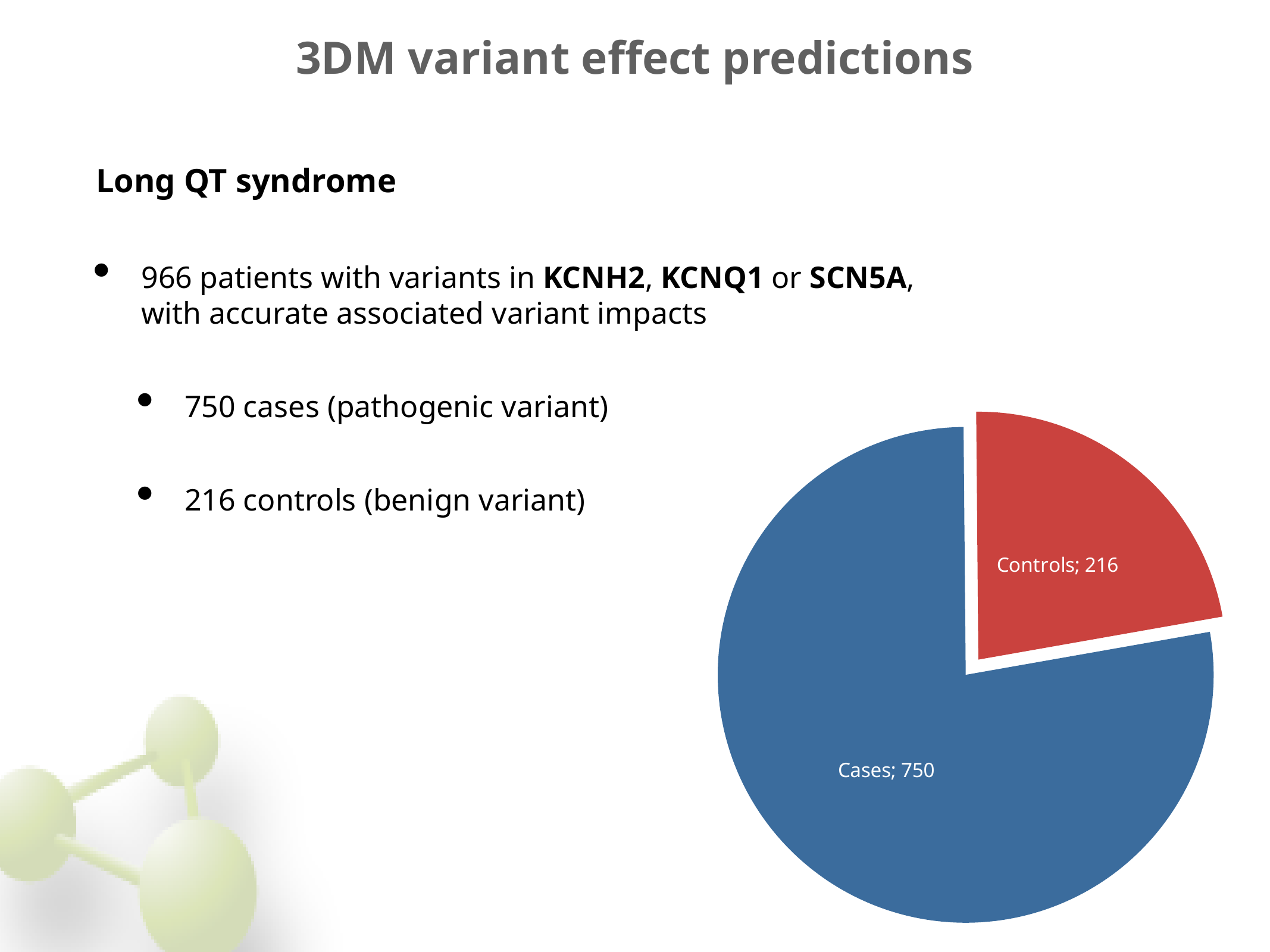
Which slice of the pie chart is the largest? Cases What is the value for Cases in the pie chart? 750 What is the total of the two slices in the pie chart? 966 What colour is the Cases slice in the pie chart? blue How many slices does the pie chart have? 2 What kind of chart is shown on the slide? pie chart What is the value for Controls in the pie chart? 216 Which slice of the pie chart is the smallest? Controls What is the difference between the Cases and Controls values in the pie chart? 534 What colour is the Controls slice in the pie chart? red Which is larger in the pie chart, Cases or Controls? Cases